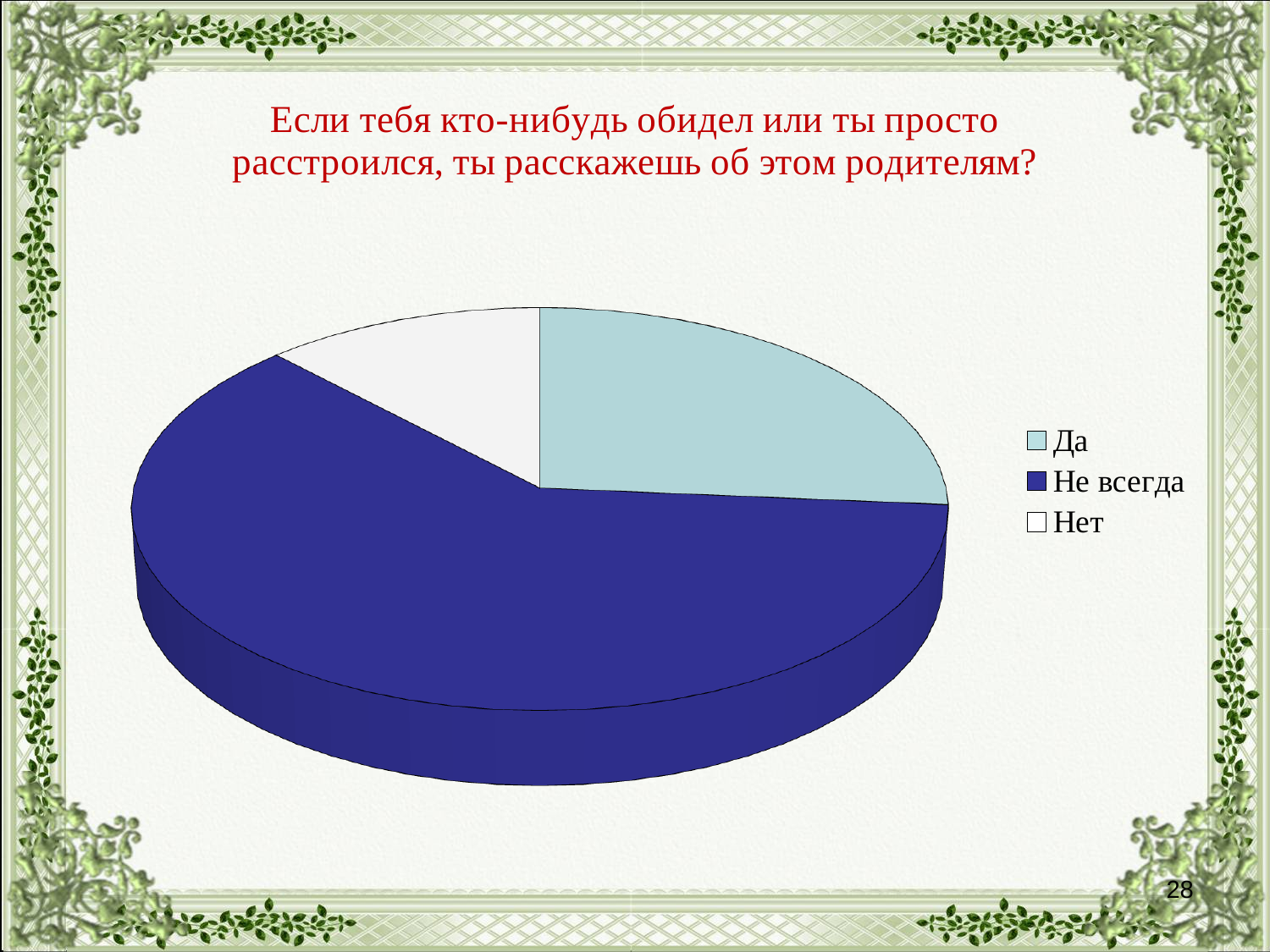
What kind of chart is shown on the slide? Pie chart How many slices does the pie chart have? 3 Which slice is larger, "Да" or "Нет"? Да Which category has the largest slice of the pie? Не всегда Which slice is larger, "Не всегда" or "Нет"? Не всегда What colour is the "Не всегда" slice in the pie chart? Dark blue Which slice is larger, "Не всегда" or "Да"? Не всегда Which legend entry is shown in white? Нет How many entries does the legend list? 3 Which category has the smallest slice of the pie? Нет